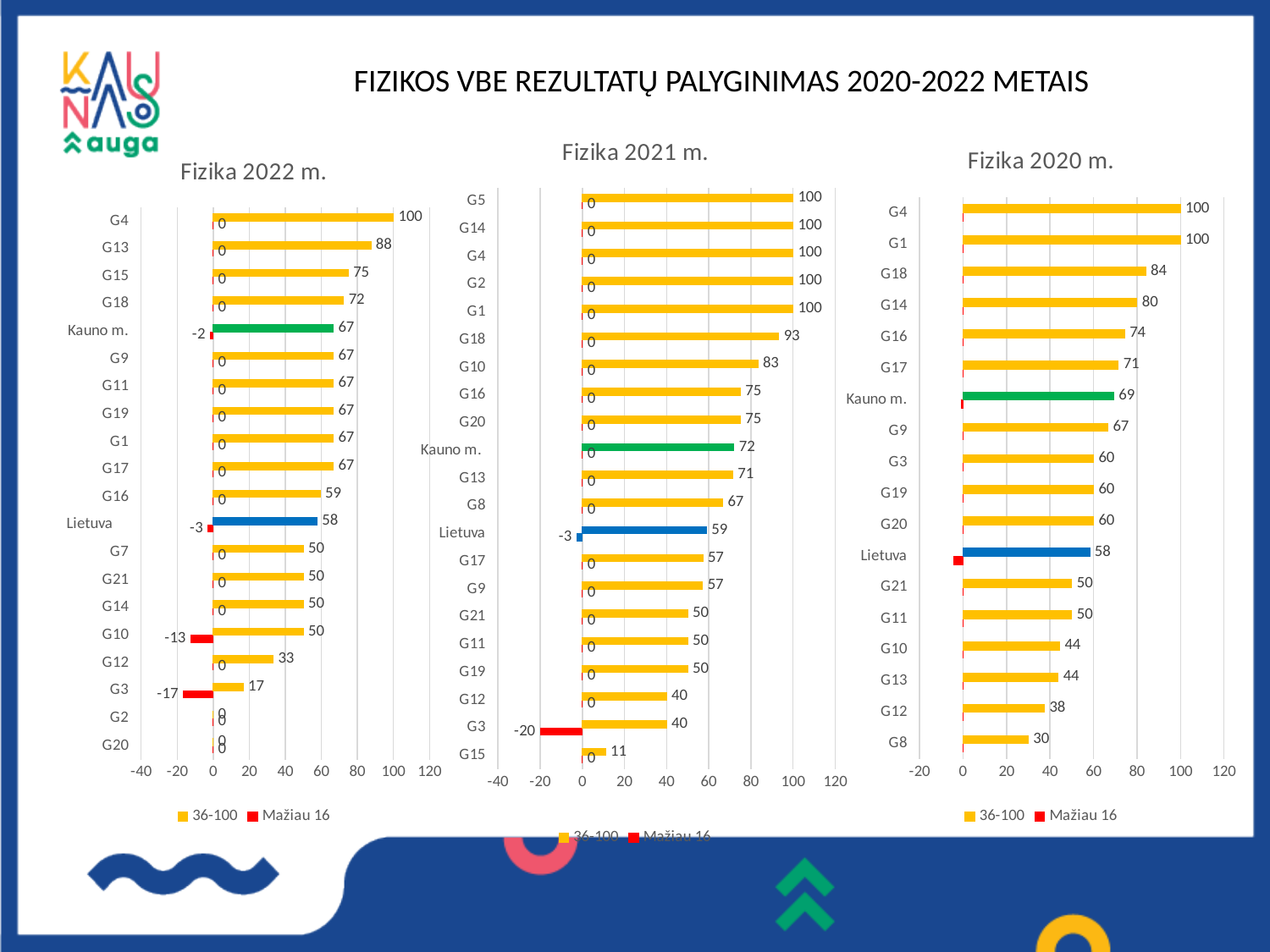
In the Fizika 2021 m. chart, which category has the lowest 36-100 value? G15 In the Fizika 2021 m. chart, what is the 36-100 value for Kauno m.? 72 In the Fizika 2022 m. chart, what is the 36-100 value for G13? 88 What type of chart is the Fizika 2022 m. chart? Bar chart In the Fizika 2020 m. chart, what is the 36-100 value for G18? 84 How many categories are shown in the Fizika 2020 m. chart? 18 In the Fizika 2022 m. chart, what is the Mažiau 16 value for G3? -17 In the Fizika 2021 m. chart, what is the Mažiau 16 value for G3? -20 In the Fizika 2020 m. chart, which category has the lowest 36-100 value? G8 In the Fizika 2020 m. chart, what is the difference between the 36-100 values for Kauno m. and Lietuva? 11 In the Fizika 2022 m. chart, what is the Mažiau 16 value for G10? -13 In the Fizika 2021 m. chart, which is larger, the 36-100 value for G18 or for G10? G18